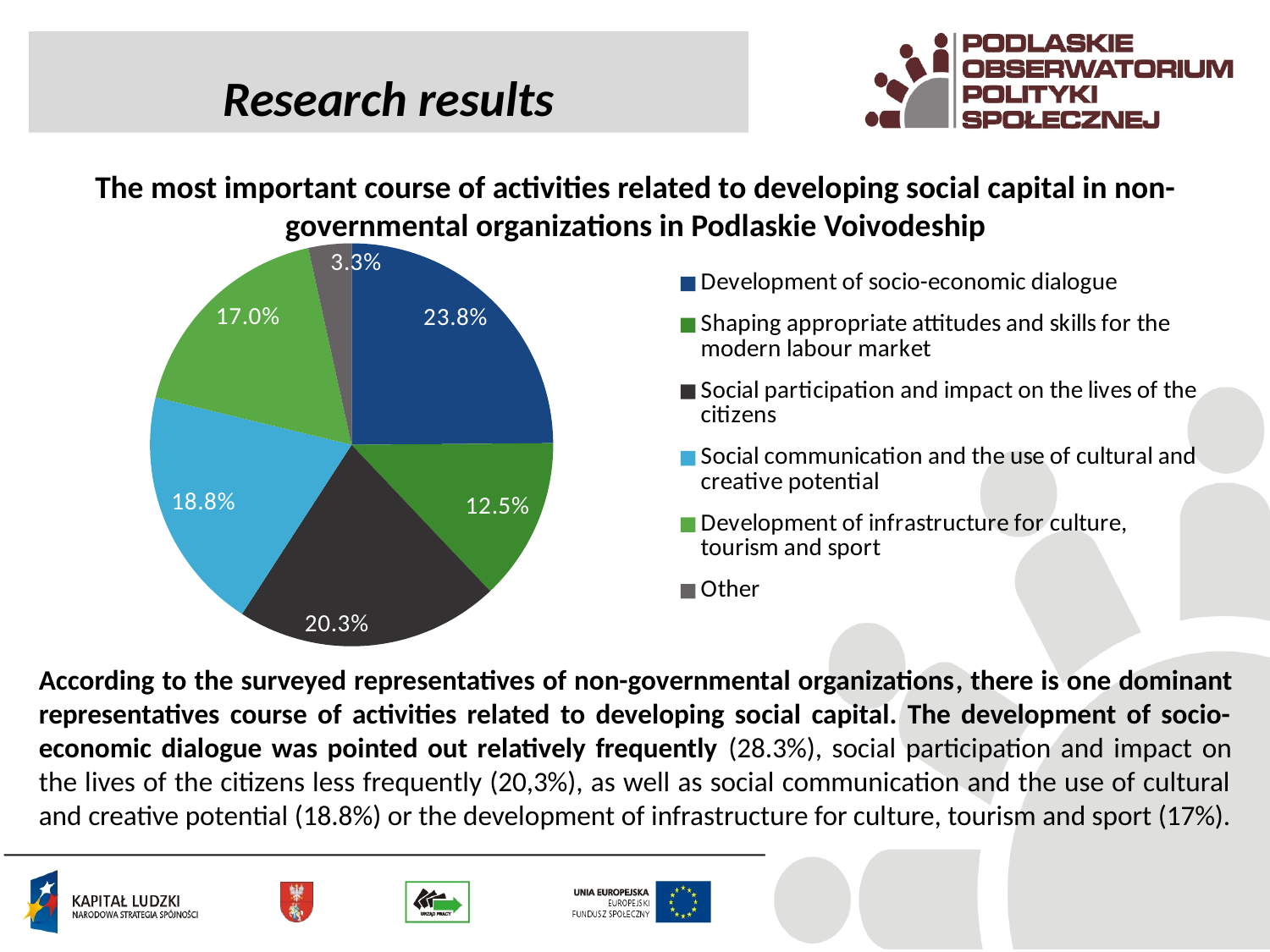
Which is larger: the slice for "Social participation and impact on the lives of the citizens" or the slice for "Development of infrastructure for culture, tourism and sport"? Social participation and impact on the lives of the citizens How many categories does the legend of the pie chart list? 6 What is the difference between the slices for "Development of socio-economic dialogue" and "Shaping appropriate attitudes and skills for the modern labour market"? 11.3% What is the value shown for "Social communication and the use of cultural and creative potential"? 18.8% What share of the pie does "Development of socio-economic dialogue" have? 23.8% What kind of chart is shown on the slide? Pie chart What is the value shown for "Other"? 3.3% Which category has the largest slice of the pie? Development of socio-economic dialogue Which category has the smallest slice of the pie? Other What colour is the slice for "Social communication and the use of cultural and creative potential"? Light blue What is the value shown for "Social participation and impact on the lives of the citizens"? 20.3% What is the value shown for "Shaping appropriate attitudes and skills for the modern labour market"? 12.5%